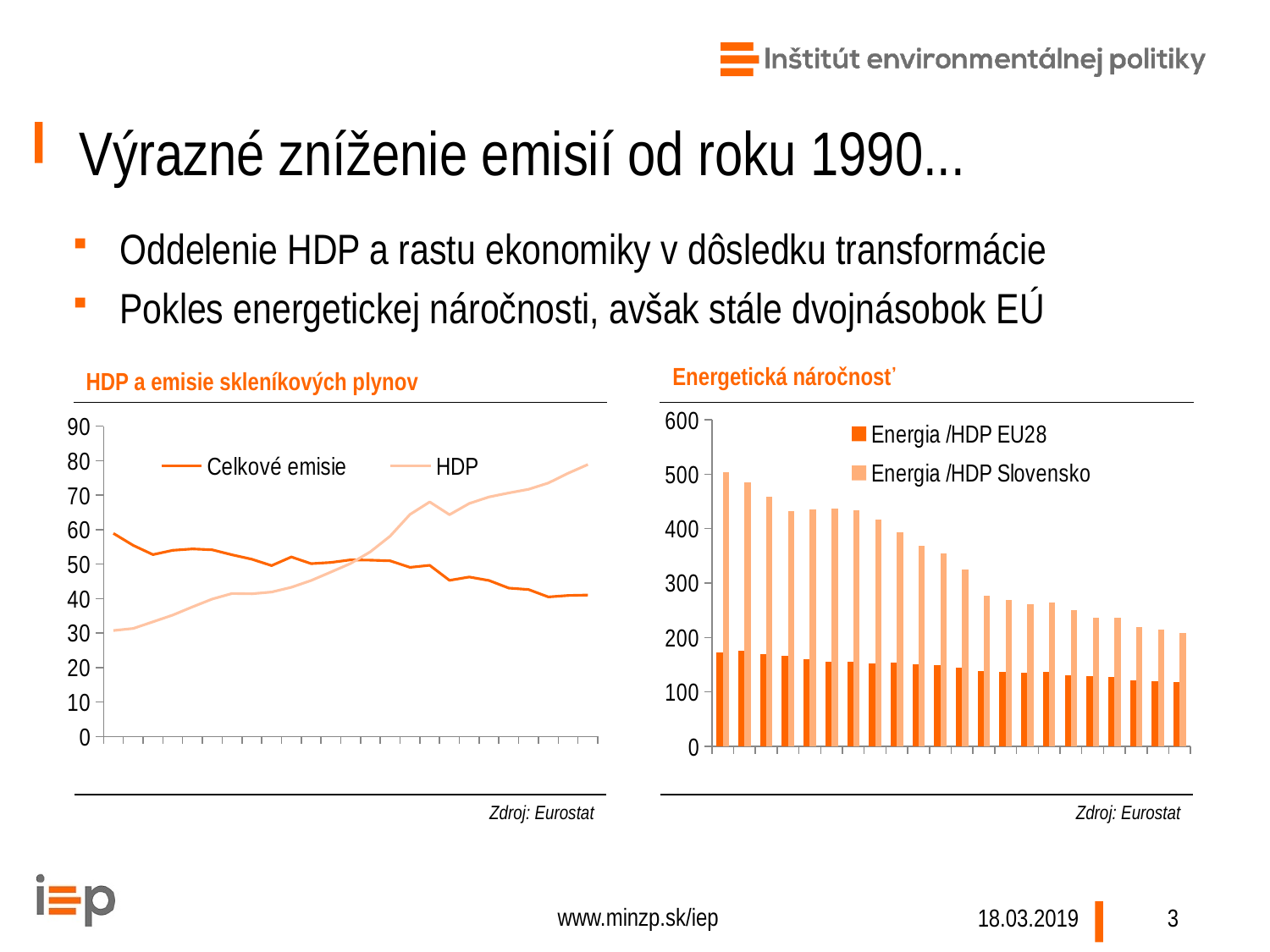
In the left chart 'HDP a emisie skleníkových plynov', does the 'HDP' line rise or fall overall along the x axis? rise What kind of chart is the right chart titled 'Energetická náročnosť'? bar chart What kind of chart is the left chart titled 'HDP a emisie skleníkových plynov'? line chart In the right chart 'Energetická náročnosť', is the first 'Energia /HDP Slovensko' bar greater or less than 400? greater How many series does the legend of the left chart 'HDP a emisie skleníkových plynov' list? 2 In the left chart 'HDP a emisie skleníkových plynov', which series is higher at the left end of the x axis, 'Celkové emisie' or 'HDP'? Celkové emisie In the left chart 'HDP a emisie skleníkových plynov', does the 'Celkové emisie' line rise or fall overall along the x axis? fall In the right chart 'Energetická náročnosť', do the 'Energia /HDP Slovensko' bars rise or fall overall along the x axis? fall In the left chart 'HDP a emisie skleníkových plynov', is the first value of the 'Celkové emisie' line greater or less than 50? greater In the right chart 'Energetická náročnosť', is the last 'Energia /HDP Slovensko' bar greater or less than 300? less How many series does the legend of the right chart 'Energetická náročnosť' list? 2